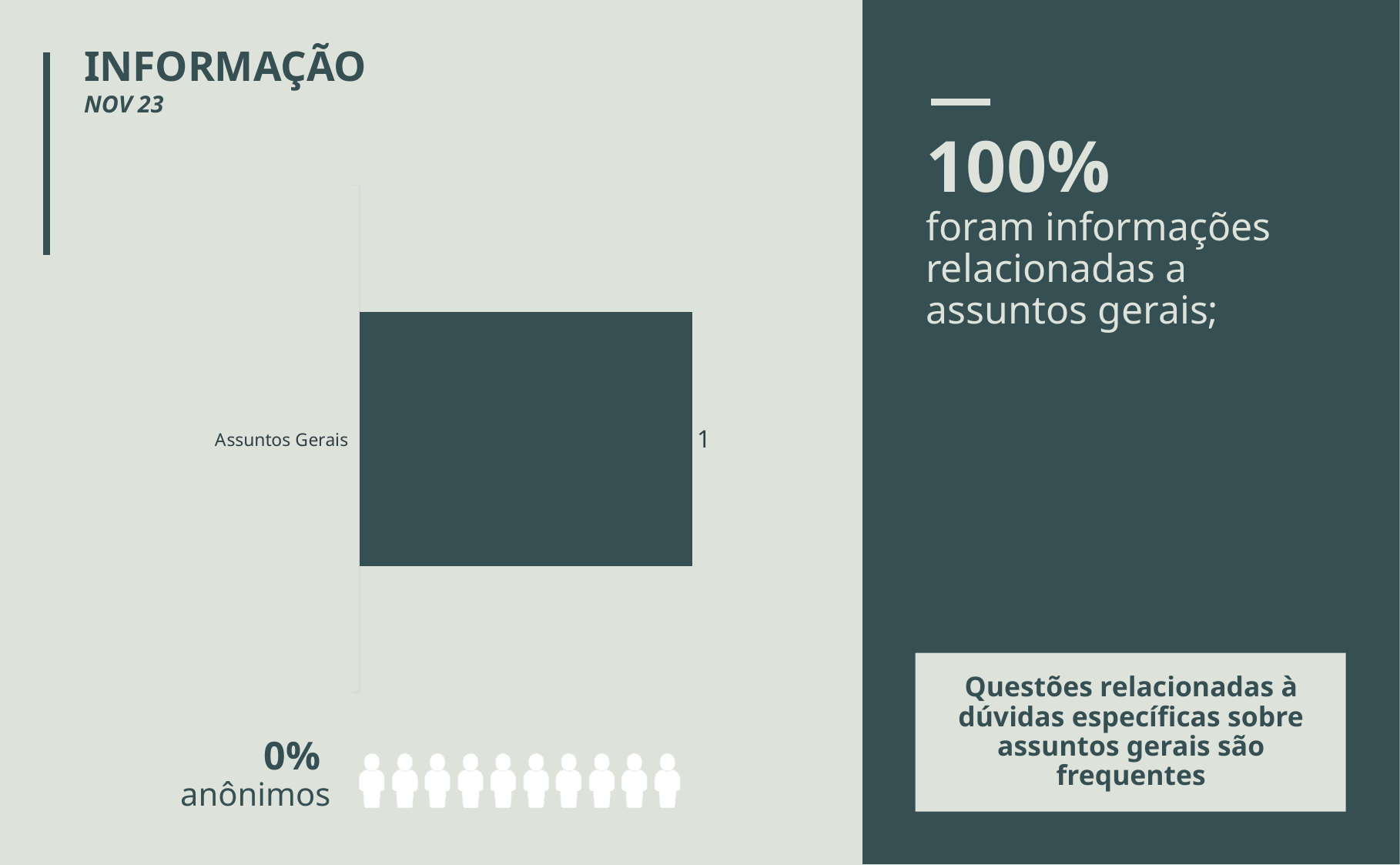
How many categories does the bar chart show? 1 What kind of chart is shown on the slide? bar chart Which category has the highest value in the bar chart? Assuntos Gerais Is the bar in the chart drawn horizontally or vertically? horizontally What is the value for Assuntos Gerais in the bar chart? 1 What is the label of the only category in the bar chart? Assuntos Gerais